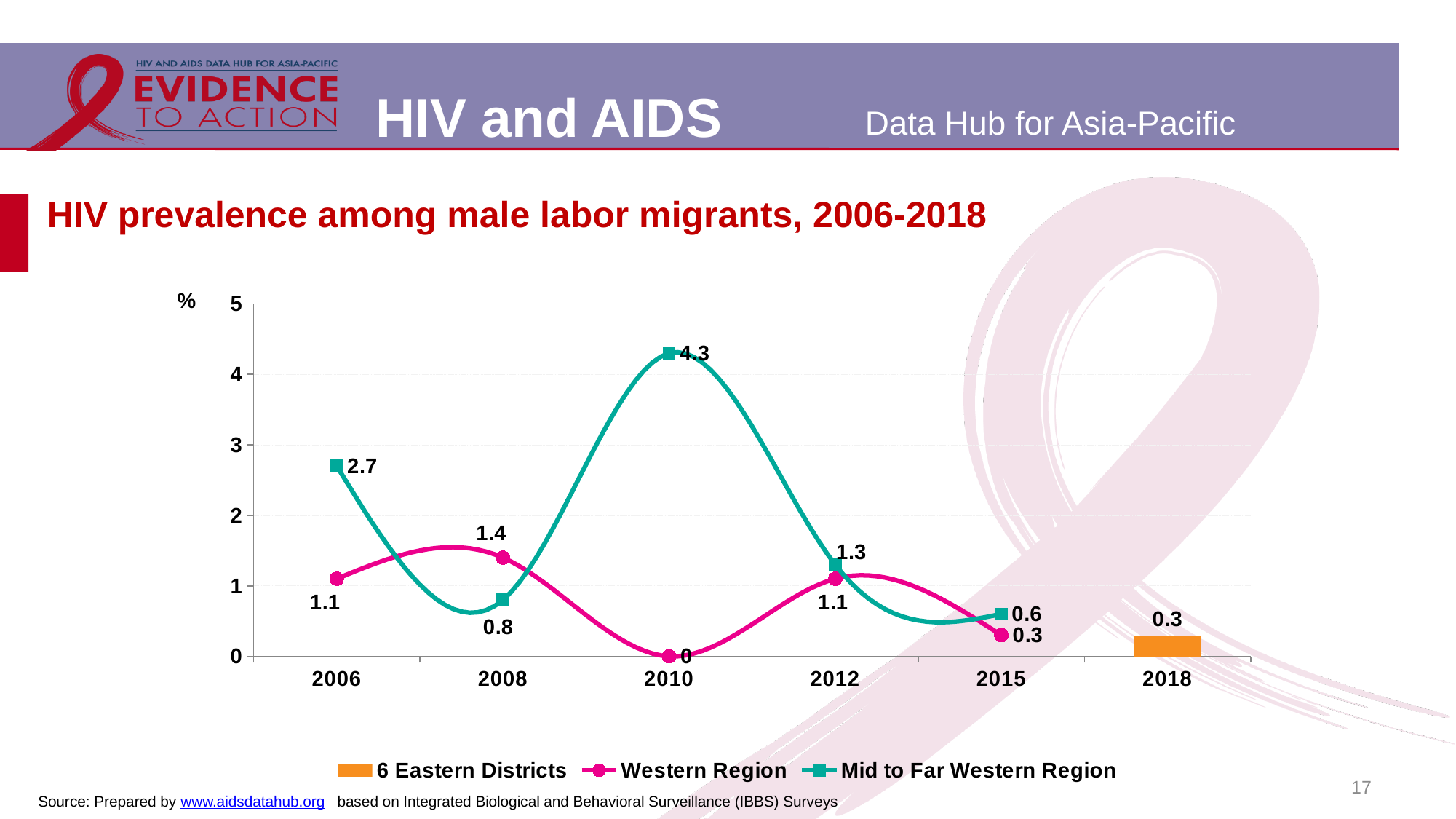
In which year does the Mid to Far Western Region reach its highest HIV prevalence? 2010 Does the Western Region's HIV prevalence rise or fall from 2012 to 2015? fall What is the HIV prevalence for the Western Region in 2008? 1.4 Which series has the higher value in 2008, the Western Region or the Mid to Far Western Region? Western Region How many series does the legend list? 3 What is the HIV prevalence for the Mid to Far Western Region in 2010? 4.3 How many years are shown on the x axis? 6 In which year is the Western Region's HIV prevalence lowest? 2010 Which series is shown as a bar rather than a line? 6 Eastern Districts What value is shown for the 6 Eastern Districts in 2018? 0.3 Is the Mid to Far Western Region value in 2010 greater or less than 4? greater What is the difference between the Mid to Far Western Region and the Western Region values in 2006? 1.6